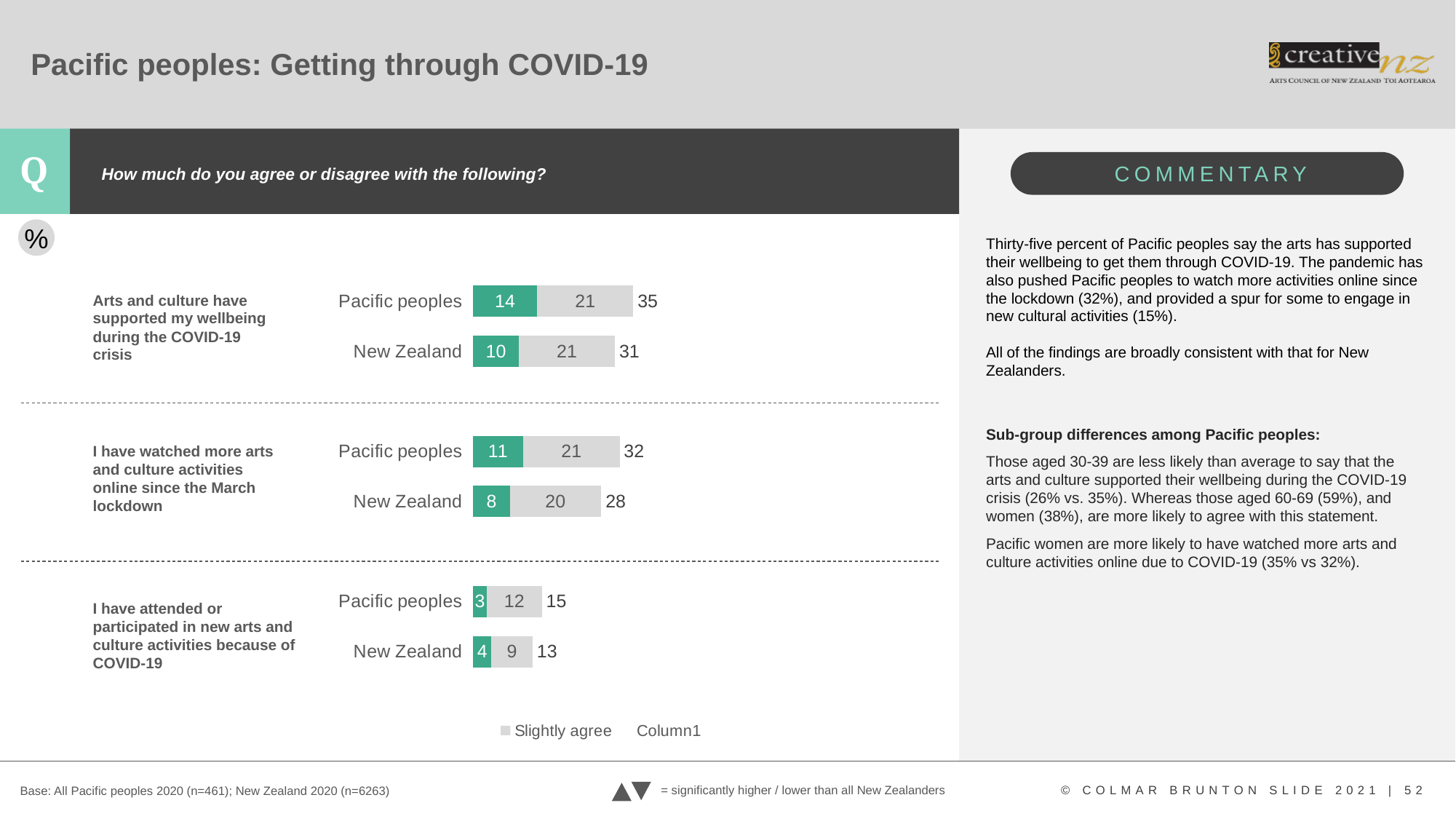
What is the 'Slightly agree' (grey) value for New Zealand on the statement 'Arts and culture have supported my wellbeing during the COVID-19 crisis'? 21 What is the value of the green segment for New Zealand on the statement 'I have attended or participated in new arts and culture activities because of COVID-19'? 4 For Pacific peoples on the statement 'Arts and culture have supported my wellbeing during the COVID-19 crisis', what is the difference between the grey 'Slightly agree' segment and the green segment? 7 What is the total percentage shown for New Zealand on the statement 'I have attended or participated in new arts and culture activities because of COVID-19'? 13 What is the total percentage shown for Pacific peoples on the statement 'Arts and culture have supported my wellbeing during the COVID-19 crisis'? 35 What entries does the chart legend list? Slightly agree, Column1 What is the value of the green segment for Pacific peoples on the statement 'I have watched more arts and culture activities online since the March lockdown'? 11 Which statement has the lowest total for Pacific peoples? I have attended or participated in new arts and culture activities because of COVID-19 How many bars are plotted on the chart in total? 6 For the statement 'I have watched more arts and culture activities online since the March lockdown', which group has the higher total: Pacific peoples or New Zealand? Pacific peoples What is the difference between the Pacific peoples total and the New Zealand total for the statement 'Arts and culture have supported my wellbeing during the COVID-19 crisis'? 4 What kind of chart is shown on the slide? Stacked bar chart